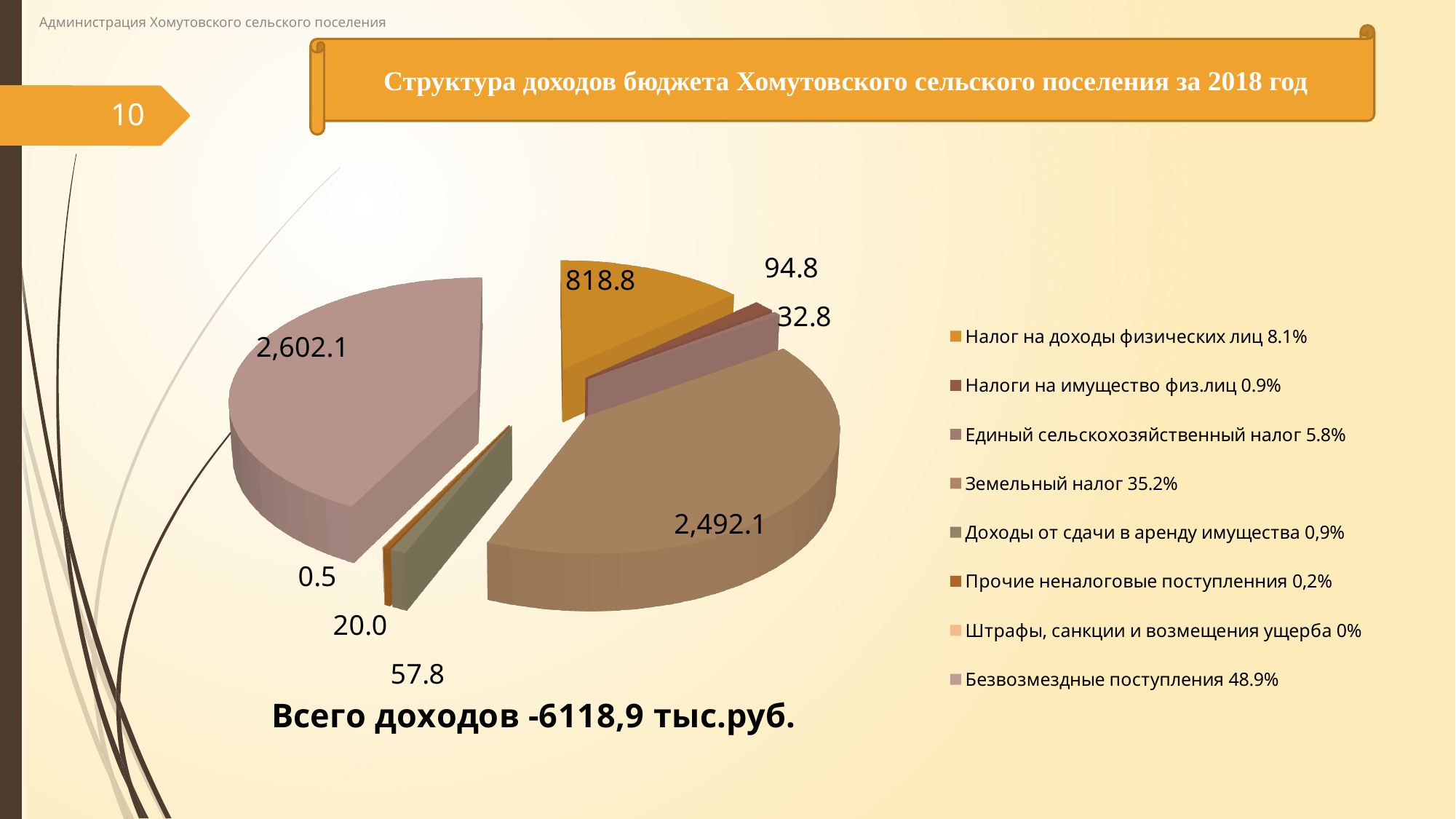
Which is larger: the value for Земельный налог or the value for Налог на доходы физических лиц? Земельный налог What is the value labelled on the slice for Земельный налог? 2,492.1 How many categories does the legend of the pie chart list? 8 According to the legend, what share of the pie does Земельный налог represent? 35.2% What is the value labelled on the slice for Налог на доходы физических лиц? 818.8 What is the difference between the values for Безвозмездные поступления and Налог на доходы физических лиц? 1,783.3 What is the difference between the values for Безвозмездные поступления and Земельный налог? 110.0 Which category has the largest slice in the pie chart? Безвозмездные поступления What is the smallest value labelled on the pie chart? 0.5 What total income is stated below the pie chart? 6118,9 тыс.руб. What kind of chart is shown on the slide? pie chart What is the value labelled on the slice for Безвозмездные поступления? 2,602.1